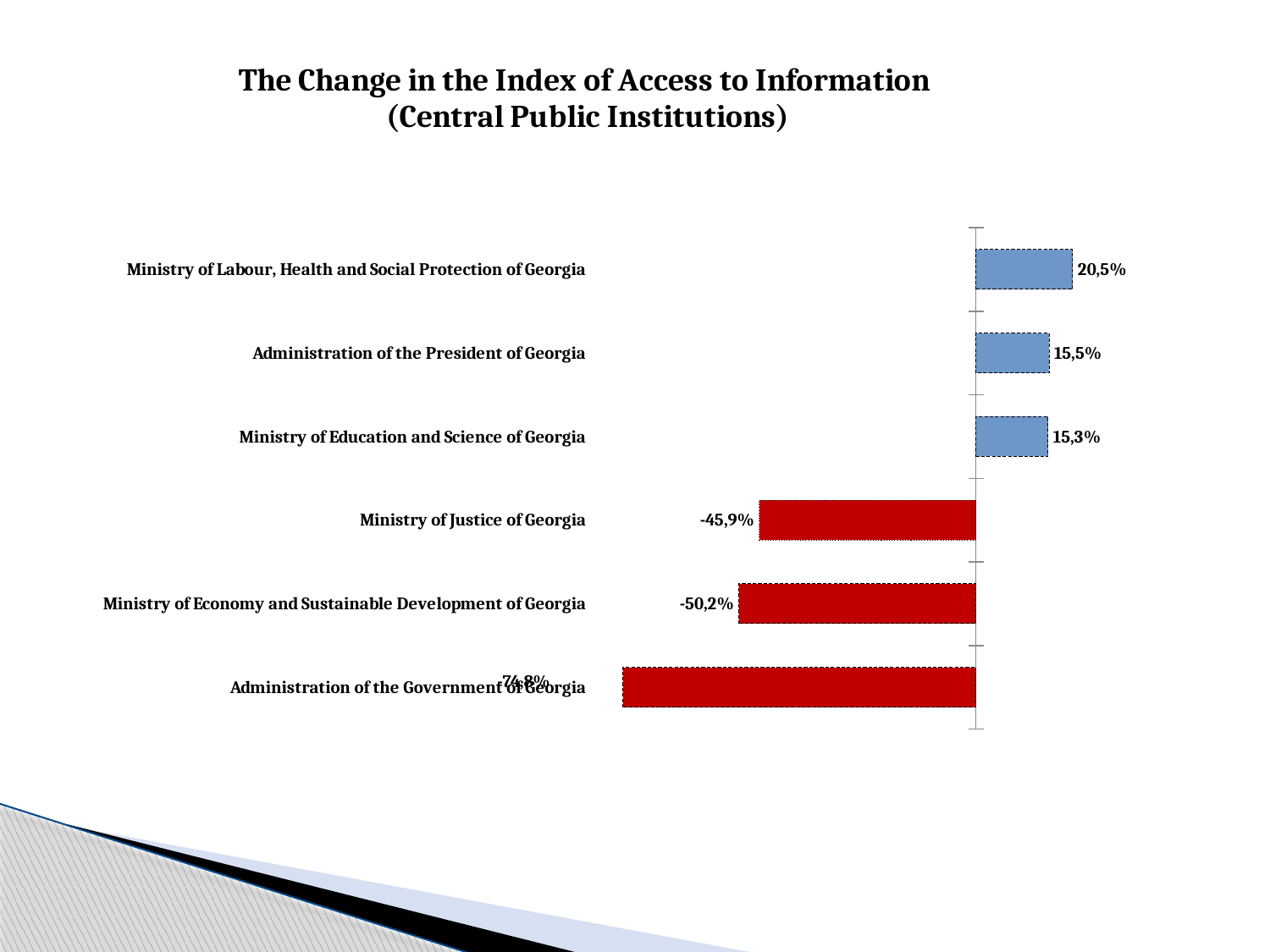
Which has the larger value: the Ministry of Justice of Georgia or the Ministry of Economy and Sustainable Development of Georgia? Ministry of Justice of Georgia What is the value for the Ministry of Education and Science of Georgia? 15,3% How many institutions are shown in the chart? 6 What type of chart is shown on the slide? Bar chart What is the difference between the values for the Ministry of Labour, Health and Social Protection of Georgia and the Administration of the President of Georgia? 5,0% What is the value for the Ministry of Labour, Health and Social Protection of Georgia? 20,5% What is the value for the Ministry of Justice of Georgia? -45,9% What is the value for the Administration of the President of Georgia? 15,5% Which institution has the highest value in the chart? Ministry of Labour, Health and Social Protection of Georgia What is the difference between the values for the Ministry of Justice of Georgia and the Ministry of Economy and Sustainable Development of Georgia? 4,3% Which institution has the lowest value in the chart? Administration of the Government of Georgia What is the value for the Ministry of Economy and Sustainable Development of Georgia? -50,2%